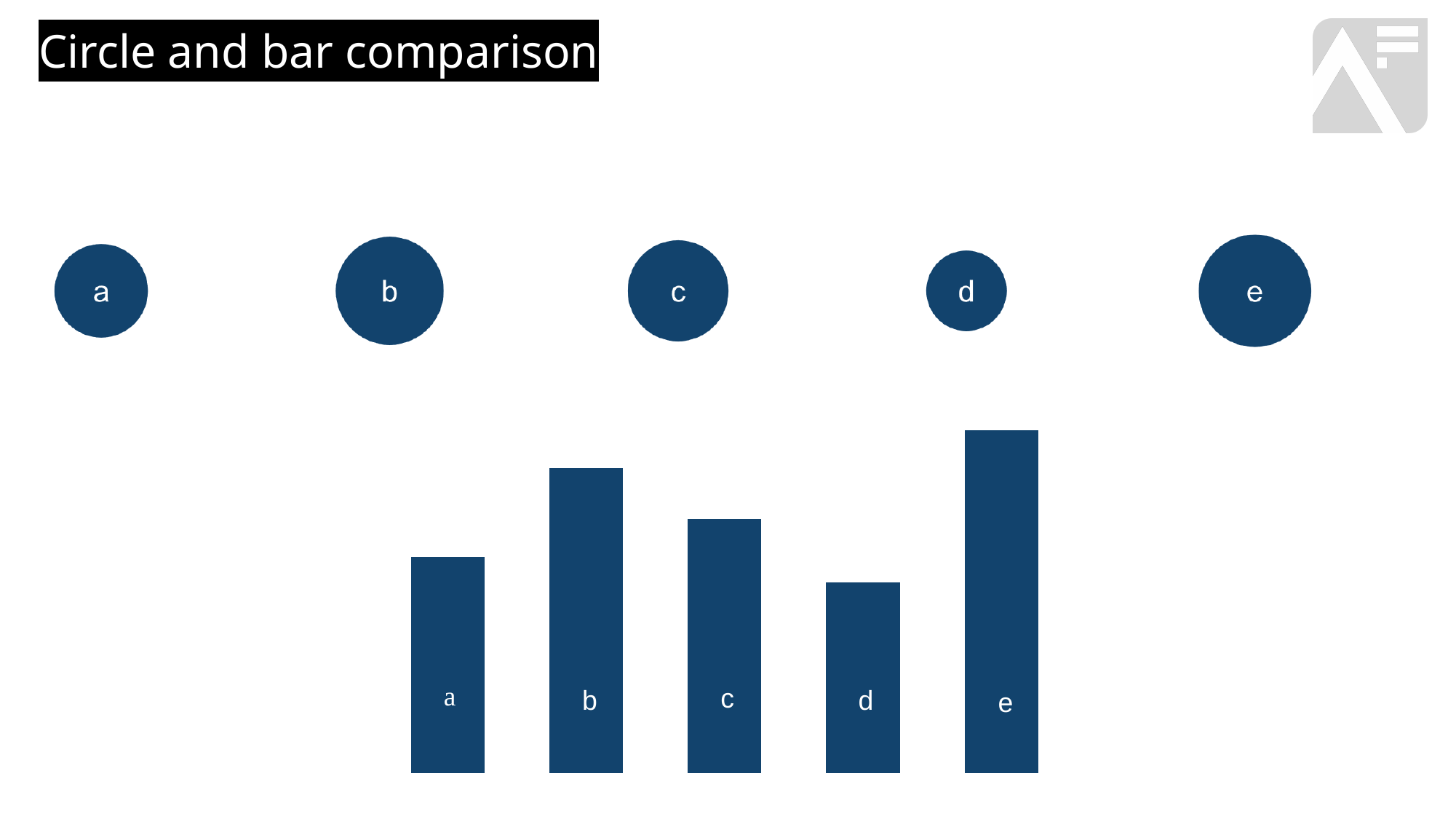
What kind of chart is shown at the bottom of the slide? bar chart In the bar chart, which bar is taller, b or c? b In the bar chart, which bar is taller, a or d? a In the bar chart, which category has the tallest bar? e In the bar chart, which category has the shortest bar? d How many circles are shown in the top row? 5 What is the title of the slide? Circle and bar comparison Among the circles in the top row, which one is the largest? e Among the circles in the top row, which is larger, a or b? b How many bars are in the bar chart? 5 Among the circles in the top row, which one is the smallest? d